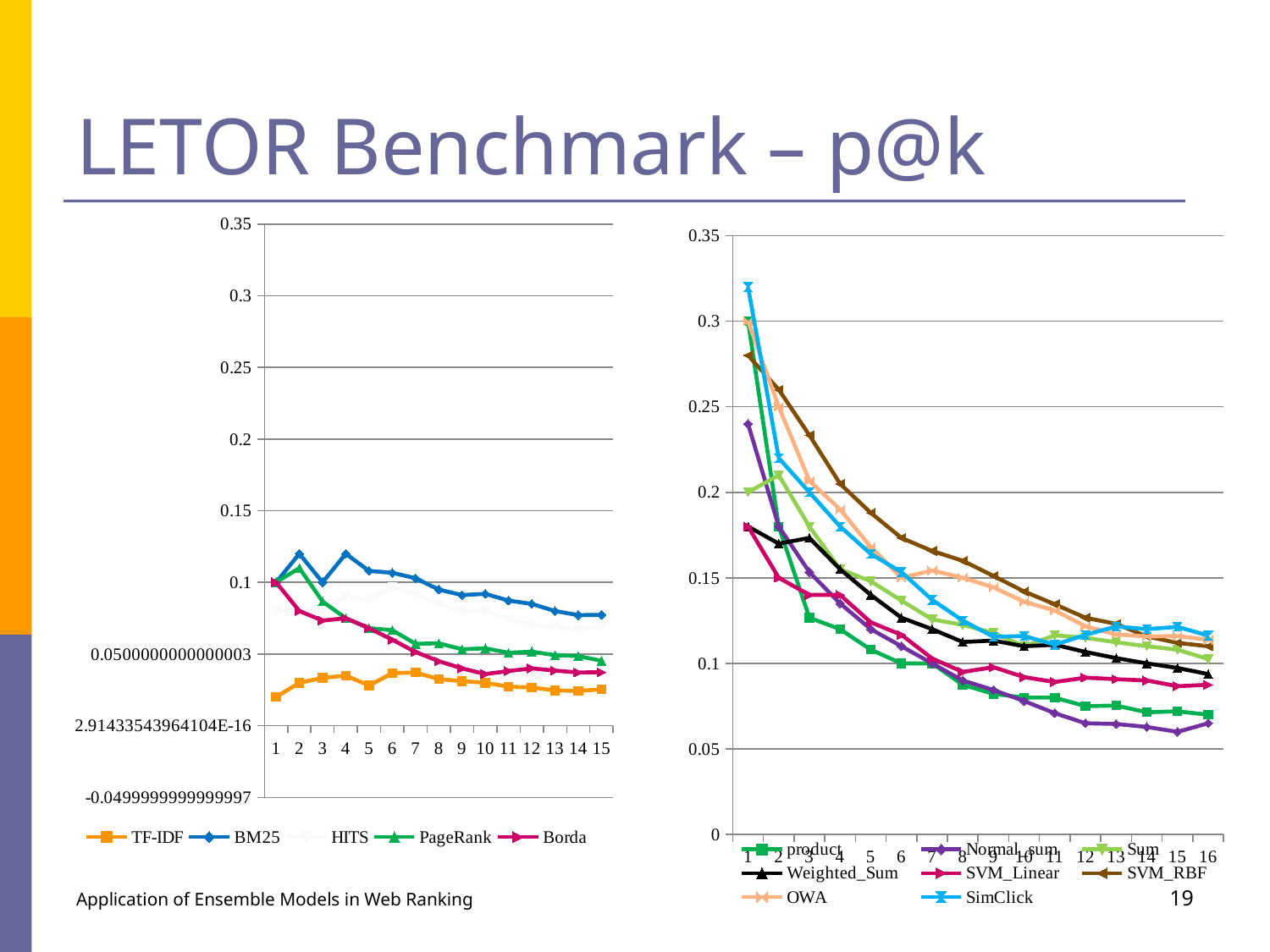
How many x-axis points are plotted in the left chart? 15 In the right chart, is the value for SimClick at x = 1 greater or less than 0.3? greater How many series does the legend of the right chart list? 8 In the right chart, do the values for SVM_RBF rise or fall as x increases from 1 to 16? fall What type of chart is the left chart on the slide? line chart In the left chart, is the value for TF-IDF at x = 1 greater or less than 0.05? less In the right chart, is the value for product at x = 16 greater or less than 0.1? less How many series does the legend of the left chart list? 5 How many x-axis points are plotted in the right chart? 16 In the left chart, which series has the lowest values across the x axis? TF-IDF In the left chart, which series has the highest values across the x axis? BM25 In the right chart, which series has the highest value at x = 1? SimClick